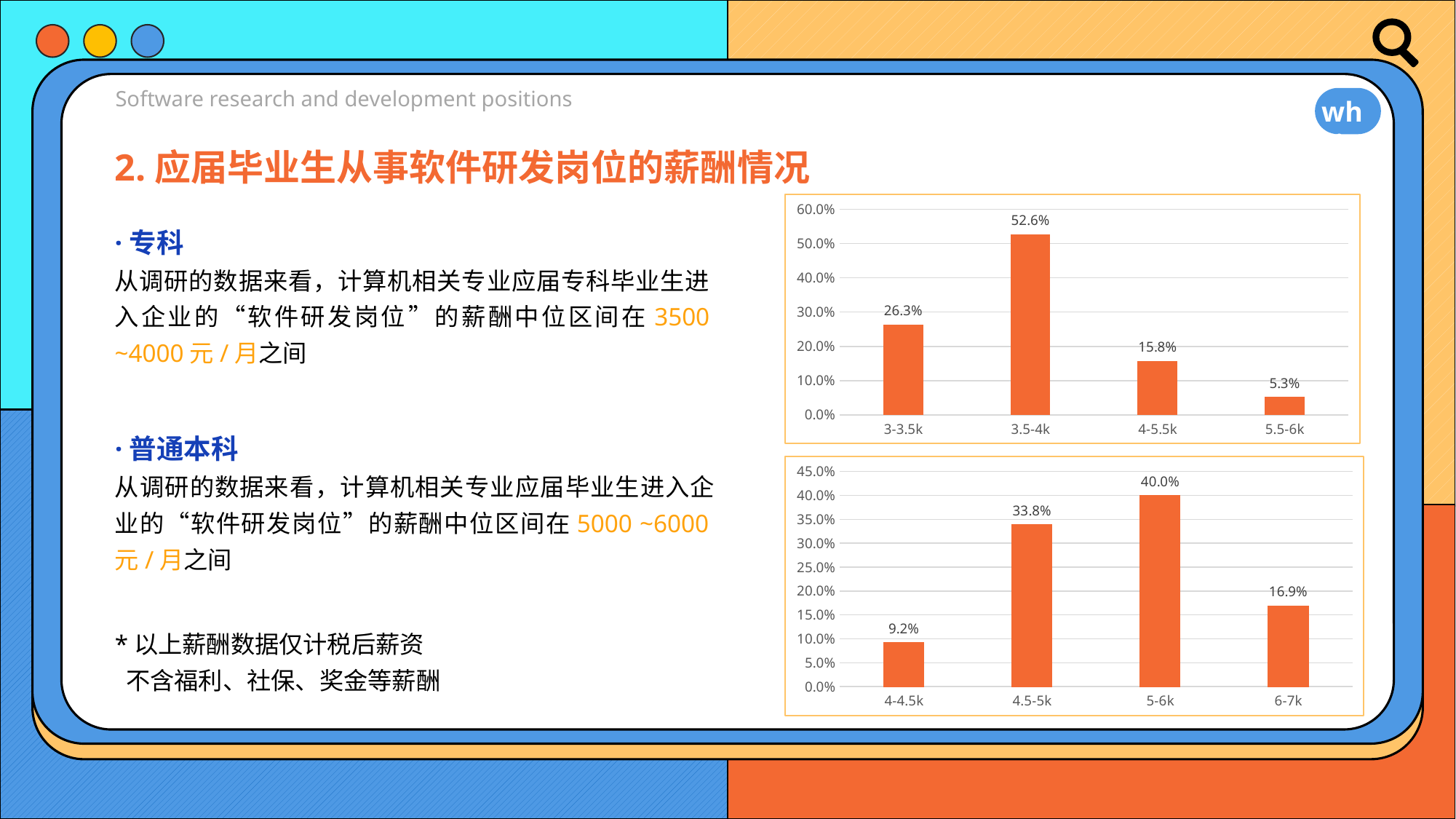
In the top chart, what is the value for 3.5-4k? 52.6% In the bottom chart, which category has the highest value? 5-6k In the top chart, is the value for 3-3.5k greater or less than 30.0%? less In the top chart, what is the difference between the values for 3-3.5k and 4-5.5k? 10.5% In the bottom chart, what is the value for 6-7k? 16.9% In the bottom chart, which is larger, the value for 4.5-5k or the value for 6-7k? 4.5-5k In the top chart, what is the value for 4-5.5k? 15.8% In the top chart, how many categories are shown on the x axis? 4 What kind of chart is the bottom chart? bar chart In the bottom chart, what is the difference between the values for 5-6k and 4-4.5k? 30.8% In the bottom chart, what is the highest value shown on the y axis? 45.0% In the top chart, which category has the lowest value? 5.5-6k